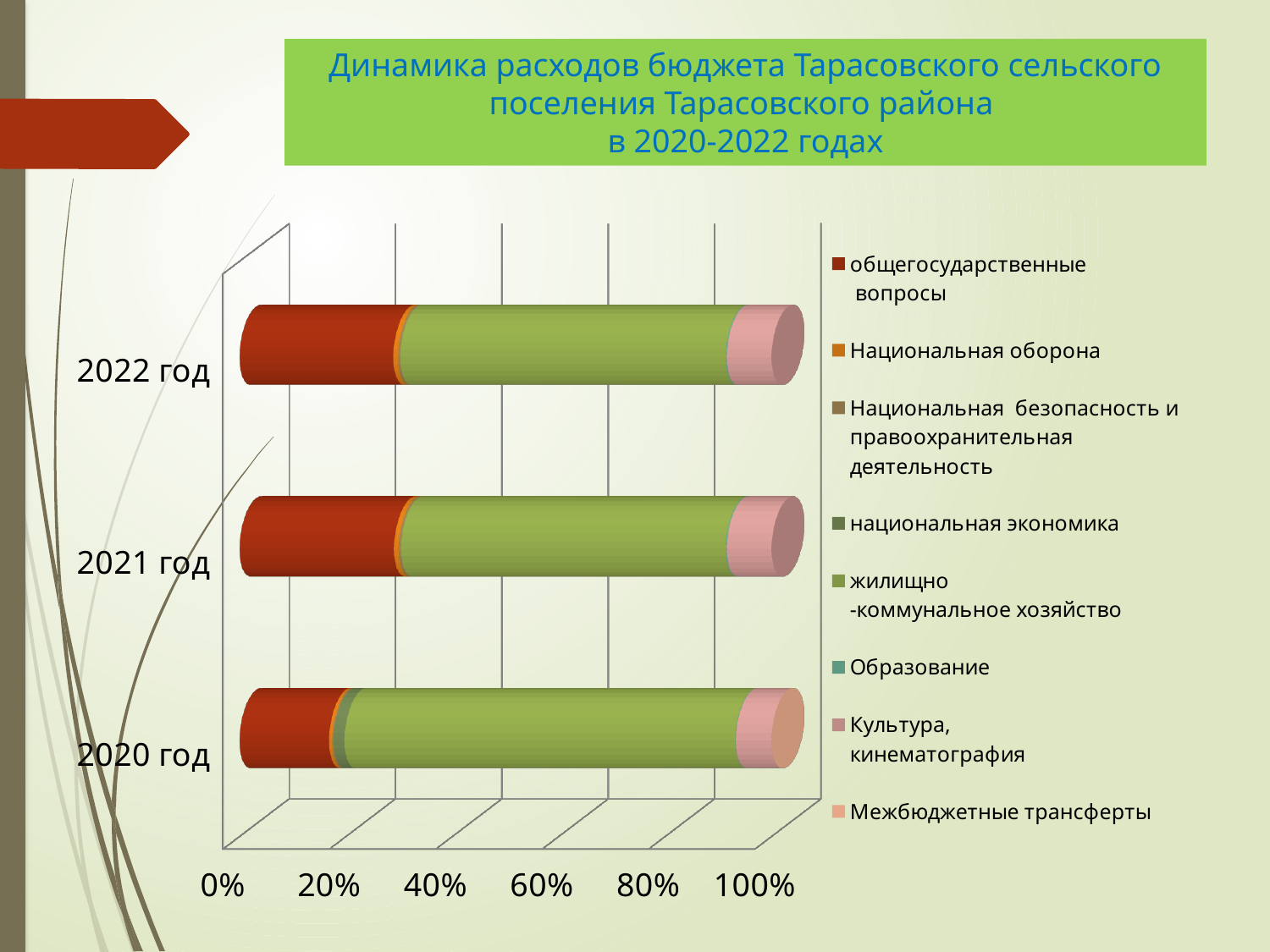
Which series takes up the largest share of the bar for 2022 год? жилищно-коммунальное хозяйство Which legend entry is shown in dark red? общегосударственные вопросы In 2021 год, which is larger: the share of жилищно-коммунальное хозяйство or the share of общегосударственные вопросы? жилищно-коммунальное хозяйство Is the share of жилищно-коммунальное хозяйство in 2021 год greater or less than 40%? greater Which series takes up the largest share of the bar for 2020 год? жилищно-коммунальное хозяйство Is the share of общегосударственные вопросы in 2022 год greater or less than 40%? less In 2022 год, which is larger: the share of общегосударственные вопросы or the share of Культура, кинематография? общегосударственные вопросы What is the title of the chart on the slide? Динамика расходов бюджета Тарасовского сельского поселения Тарасовского района в 2020-2022 годах How many series does the chart legend list? 8 Is the share of общегосударственные вопросы in 2020 год greater or less than 20%? less How many years (categories) are plotted on the chart? 3 What kind of chart is shown on the slide? bar chart